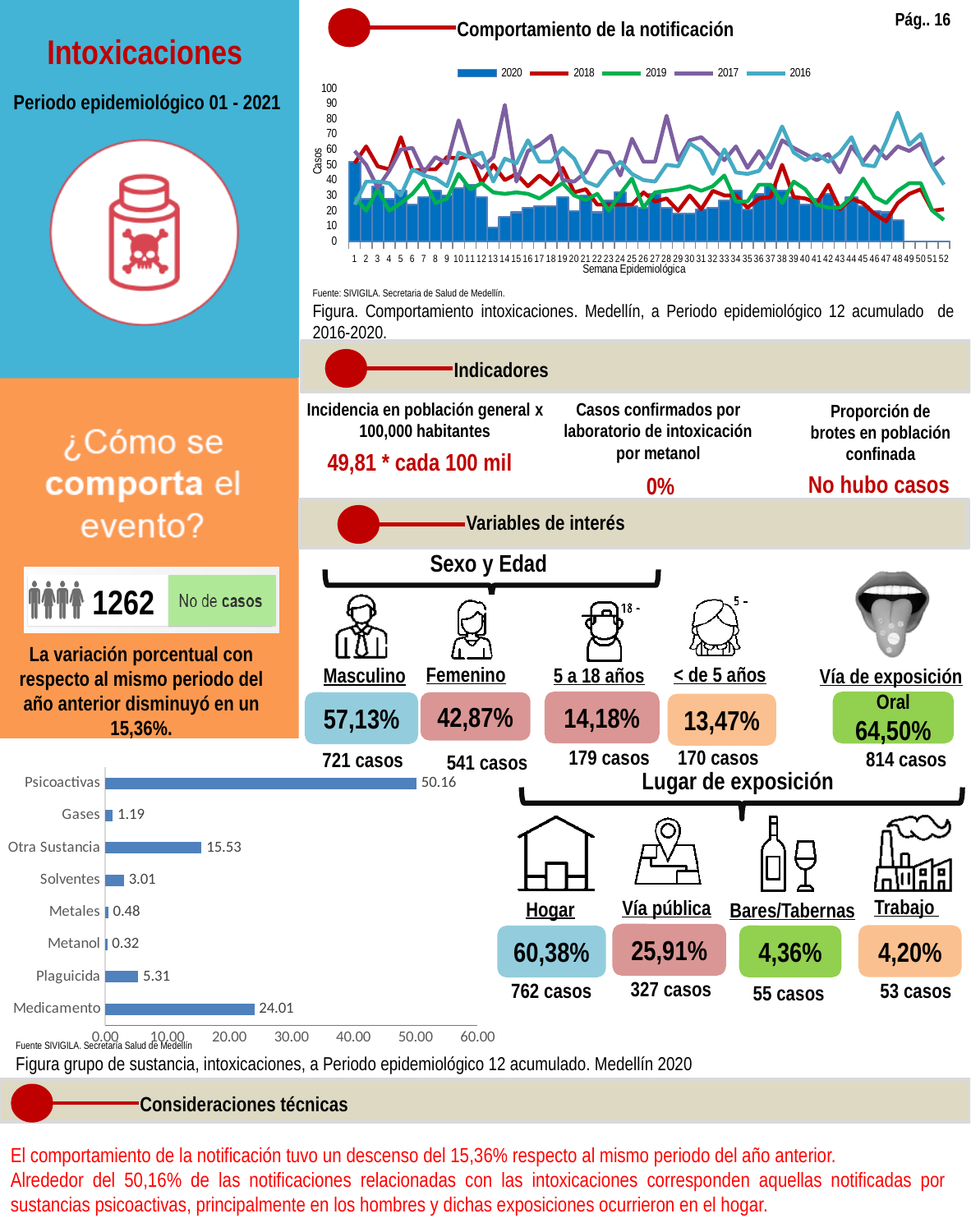
How many series does the legend list in the top chart 'Comportamiento de la notificación'? 5 What kind of chart is the bottom-left chart of substance groups? Bar chart In the bottom-left bar chart of substance groups, what is the value for Medicamento? 24.01 In the bottom-left bar chart of substance groups, what is the value for Psicoactivas? 50.16 In the bottom-left bar chart of substance groups, what is the value for Metanol? 0.32 In the top chart 'Comportamiento de la notificación', what is the label of the x axis? Semana Epidemiológica How many categories are shown in the bottom-left bar chart of substance groups? 8 In the bottom-left bar chart of substance groups, which category has the highest value? Psicoactivas In the bottom-left bar chart of substance groups, what is the difference between Psicoactivas and Medicamento? 26.15 In the top chart 'Comportamiento de la notificación', is the value for 2017 at week 13 greater or less than 80? less In the bottom-left bar chart of substance groups, which category has the lowest value? Metanol In the bottom-left bar chart of substance groups, which is larger, Plaguicida or Solventes? Plaguicida